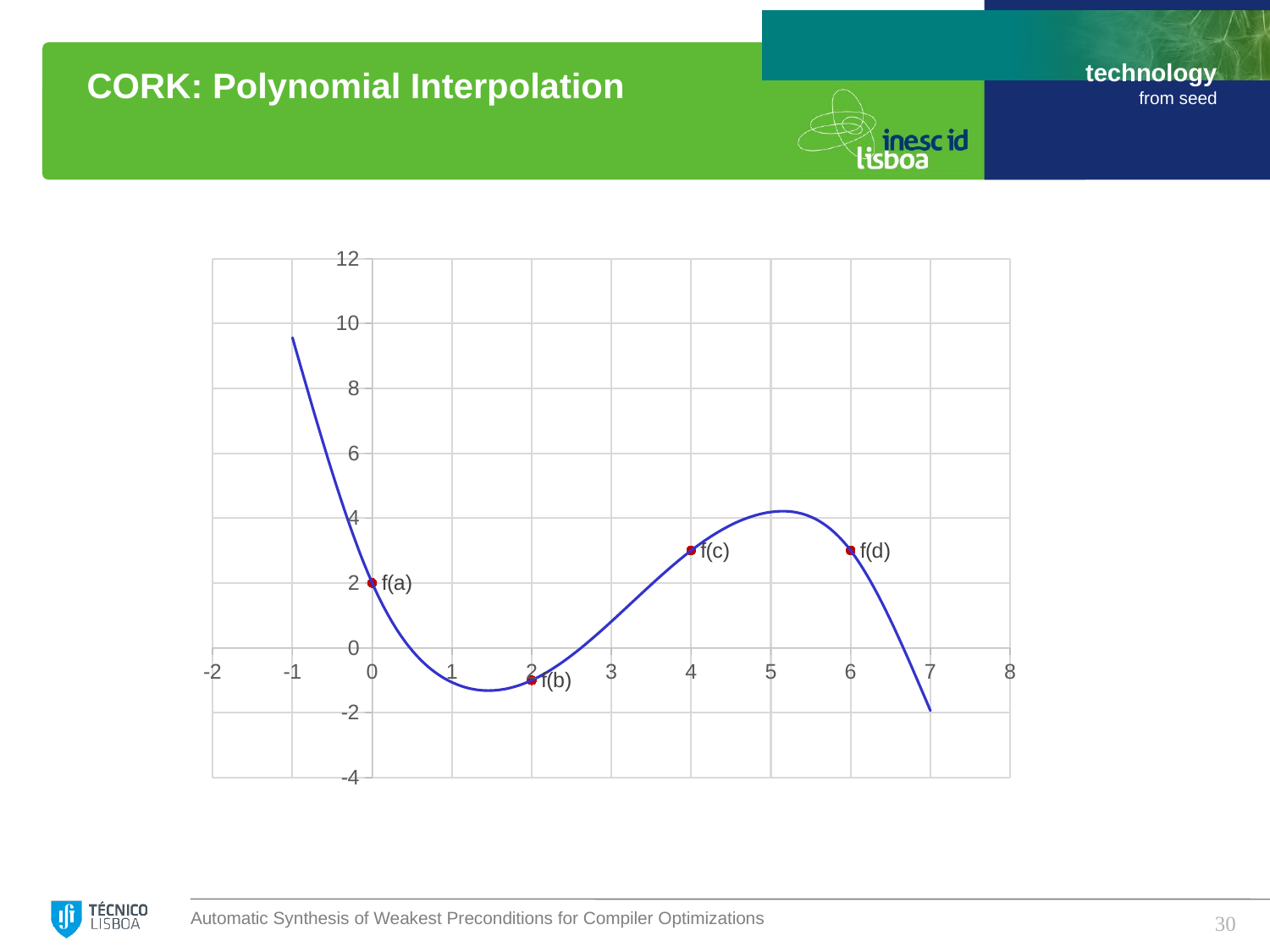
At which x value is the point labelled f(a) located? 0 At which x value is the point labelled f(c) located? 4 Which has the larger y value, f(a) or f(b)? f(a) At which x value is the point labelled f(d) located? 6 How many labelled points are marked on the curve? 4 Which of the labelled points has the lowest y value? f(b) What kind of chart is shown on the slide? line chart What is the title of the slide containing the chart? CORK: Polynomial Interpolation Is the value of the curve at x = -1 greater or less than 8? greater Does the curve rise or fall between x = 2 and x = 5? rise Is the y value of the point f(c) greater or less than 2? greater Is the y value of the point f(b) greater or less than 0? less